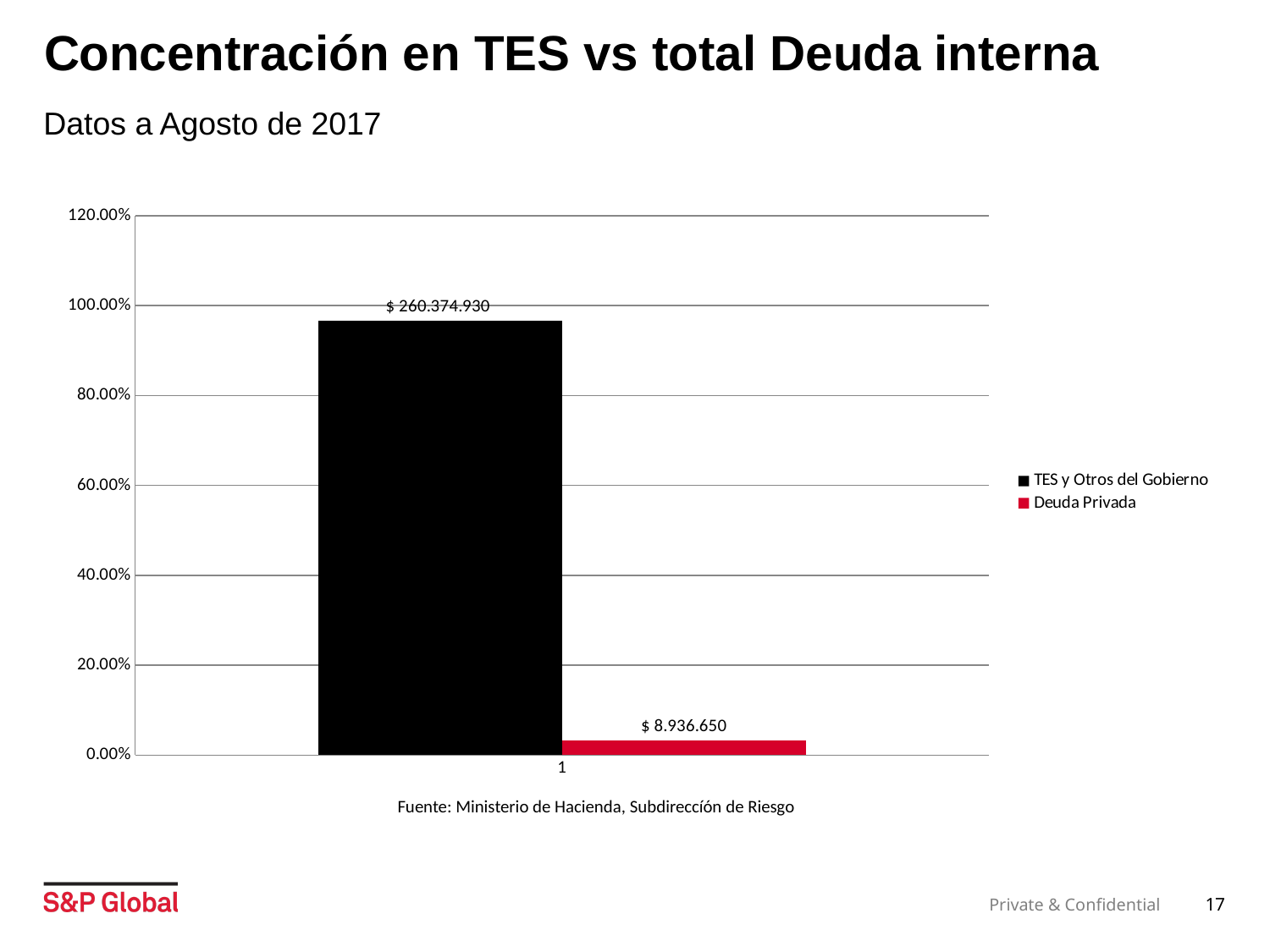
Is the bar for TES y Otros del Gobierno greater or less than 80.00% on the axis? greater Which series has the lowest value in the chart? Deuda Privada What source is cited below the chart? Ministerio de Hacienda, Subdireccíón de Riesgo What is the difference between the labelled values for TES y Otros del Gobierno and Deuda Privada? $ 251.438.280 What colour is the bar for Deuda Privada? Red What kind of chart is shown on the slide? Bar chart What data label is shown on the bar for Deuda Privada? $ 8.936.650 How many series does the legend list? 2 Which series has the highest value in the chart? TES y Otros del Gobierno What data label is shown on the bar for TES y Otros del Gobierno? $ 260.374.930 Which series has the taller bar, TES y Otros del Gobierno or Deuda Privada? TES y Otros del Gobierno Is the bar for Deuda Privada greater or less than 20.00% on the axis? less